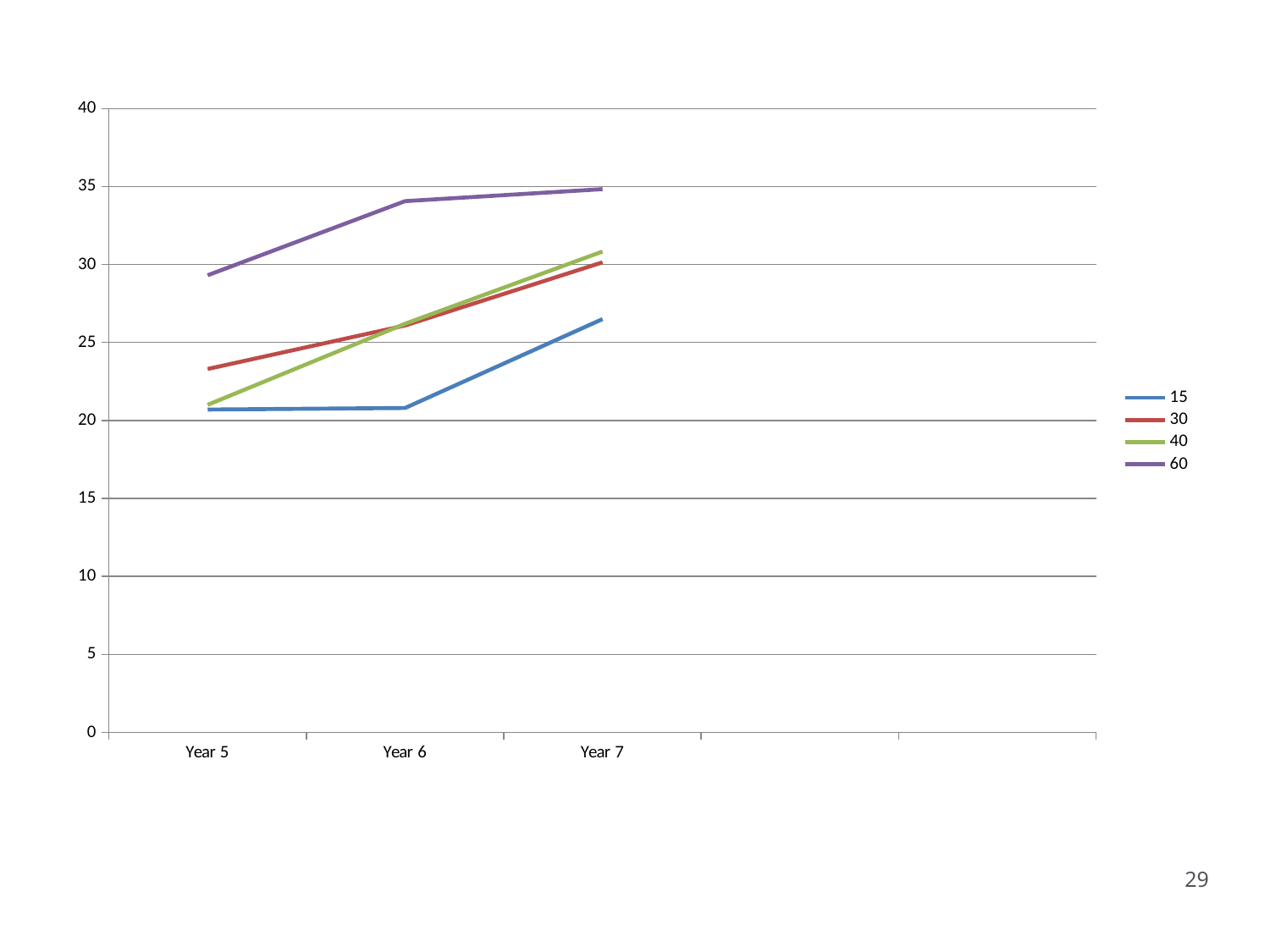
Is the value for series 15 at Year 5 greater or less than 25? less Is the value for series 60 at Year 6 greater or less than 30? greater How many labelled categories are on the x axis? 3 Which series has the highest value at Year 7? 60 Which is larger at Year 6: the value for series 60 or the value for series 15? 60 Which is larger at Year 5: the value for series 30 or the value for series 15? 30 Which series has the lowest value at Year 7? 15 How many series does the legend list? 4 Does the value for series 60 rise or fall from Year 5 to Year 7? rise Which series has the highest value at Year 5? 60 What kind of chart is shown on the slide? line chart Is the value for series 60 at Year 5 greater or less than 25? greater